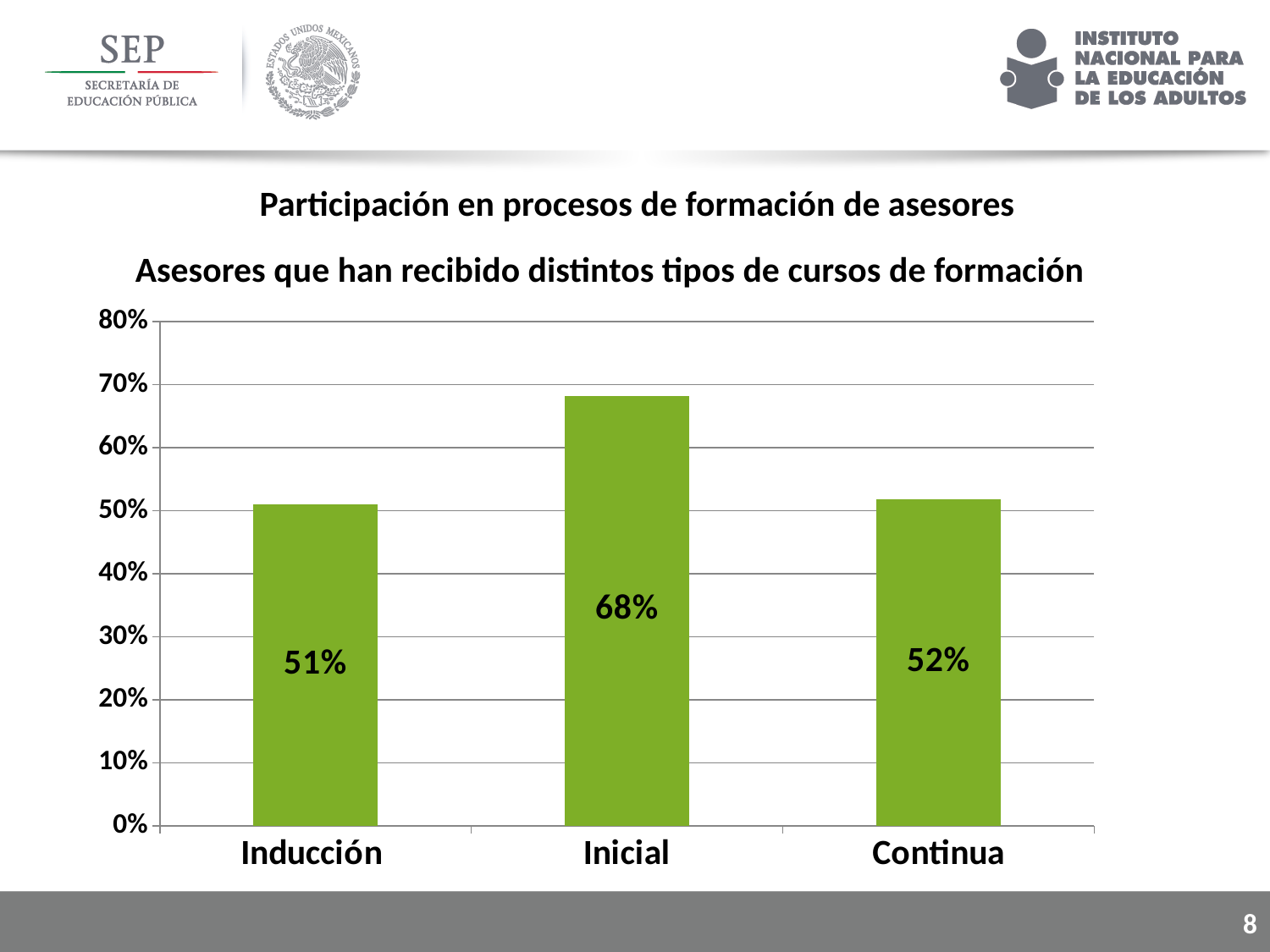
What is the value for Continua? 52% Which category has the highest value? Inicial How many categories are shown on the x axis? 3 What kind of chart is shown on the slide? bar chart What is the difference between the values for Inicial and Continua? 16% What is the value for Inducción? 51% What is the difference between the values for Inicial and Inducción? 17% What is the title of the chart? Asesores que han recibido distintos tipos de cursos de formación Which is larger, the value for Inicial or the value for Continua? Inicial Is the value for Inicial greater or less than 60%? greater Which category has the lowest value? Inducción What is the value for Inicial? 68%